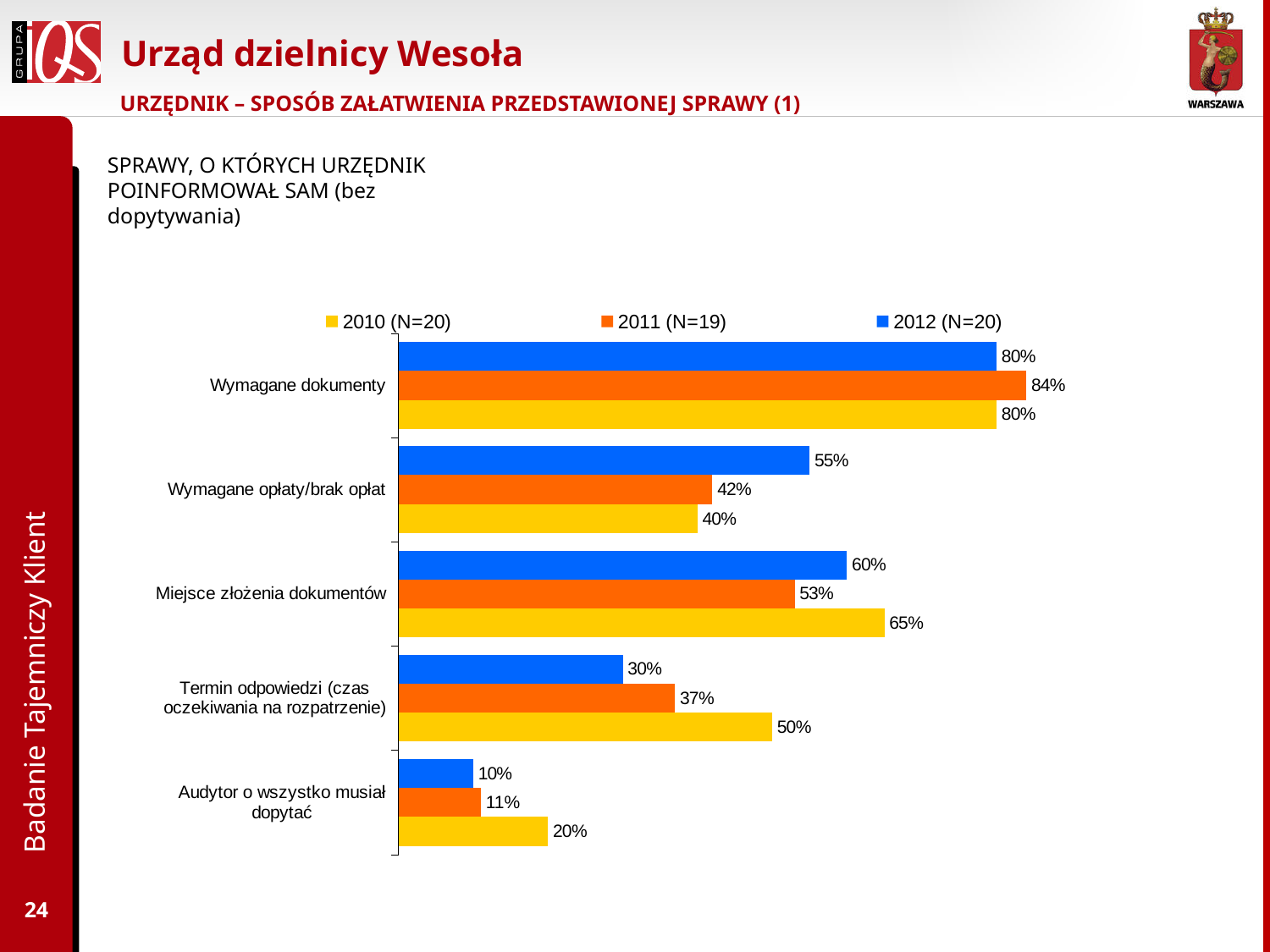
What is the value for "Audytor o wszystko musiał dopytać" in the 2011 (N=19) series? 11% What is the value for "Termin odpowiedzi (czas oczekiwania na rozpatrzenie)" in the 2010 (N=20) series? 50% How many categories are shown on the chart? 5 For "Miejsce złożenia dokumentów", which series has the larger value: 2010 (N=20) or 2011 (N=19)? 2010 (N=20) How many series does the legend list? 3 Which category has the highest value in the 2012 (N=20) series? Wymagane dokumenty What is the value for "Wymagane dokumenty" in the 2011 (N=19) series? 84% What is the value for "Wymagane opłaty/brak opłat" in the 2012 (N=20) series? 55% What kind of chart is shown on the slide? Bar chart Which category has the lowest value in the 2010 (N=20) series? Audytor o wszystko musiał dopytać Which colour represents the 2011 (N=19) series in the chart? Orange What is the difference between the 2010 (N=20) and 2012 (N=20) values for "Termin odpowiedzi (czas oczekiwania na rozpatrzenie)"? 20%